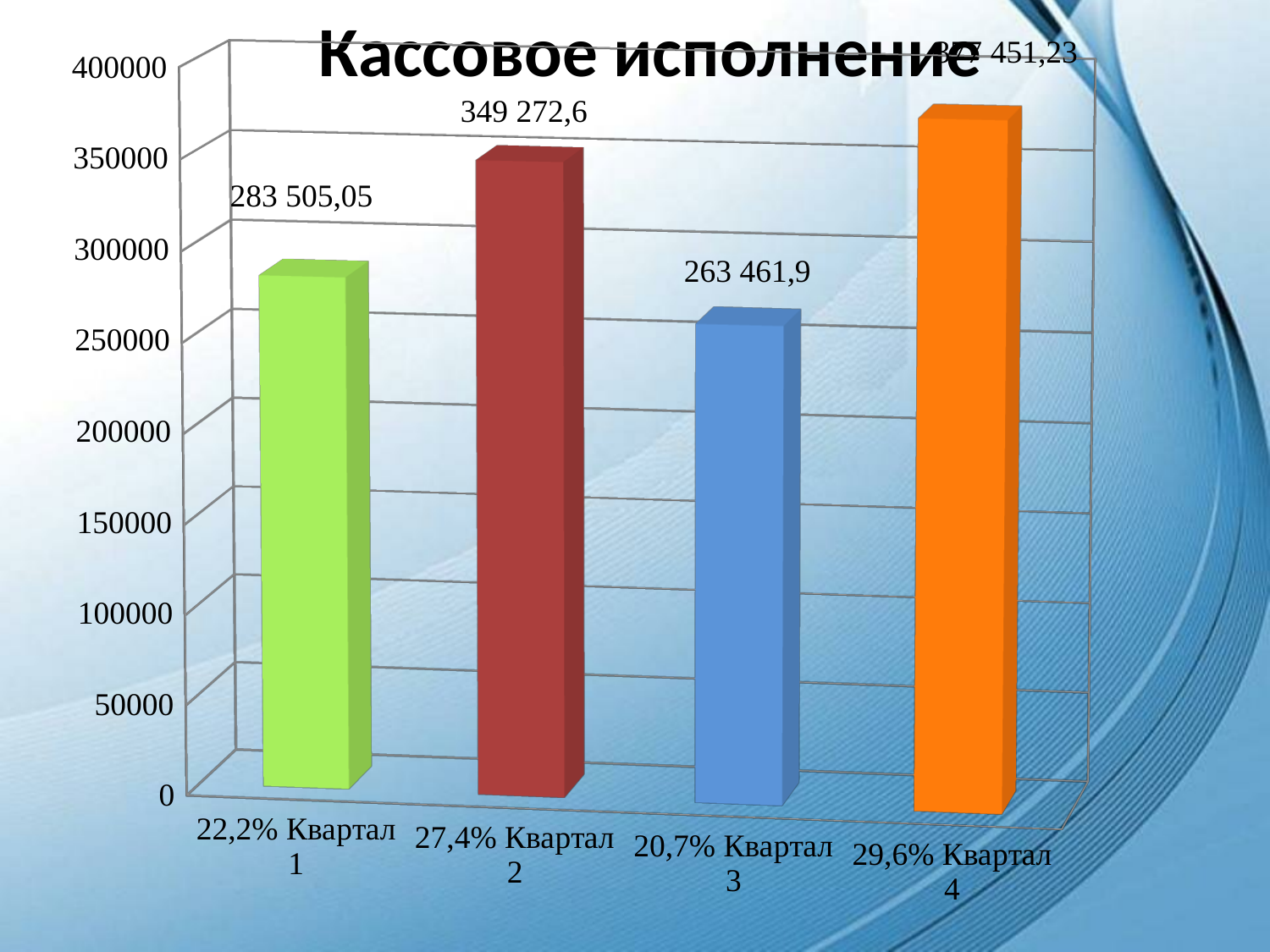
What is the value for Квартал 3? 263 461,9 Which is larger, the value for Квартал 2 or the value for Квартал 3? Квартал 2 Which quarter has the highest value? Квартал 4 How many bars are shown in the chart? 4 What is the difference between the values for Квартал 2 and Квартал 1? 65 767,55 What is the value for Квартал 1? 283 505,05 What is the difference between the values for Квартал 1 and Квартал 3? 20 043,15 What is the value for Квартал 2? 349 272,6 What is the title of the chart? Кассовое исполнение What kind of chart is shown on the slide? bar chart Is the value for Квартал 4 greater or less than 350000? greater Which quarter has the lowest value? Квартал 3